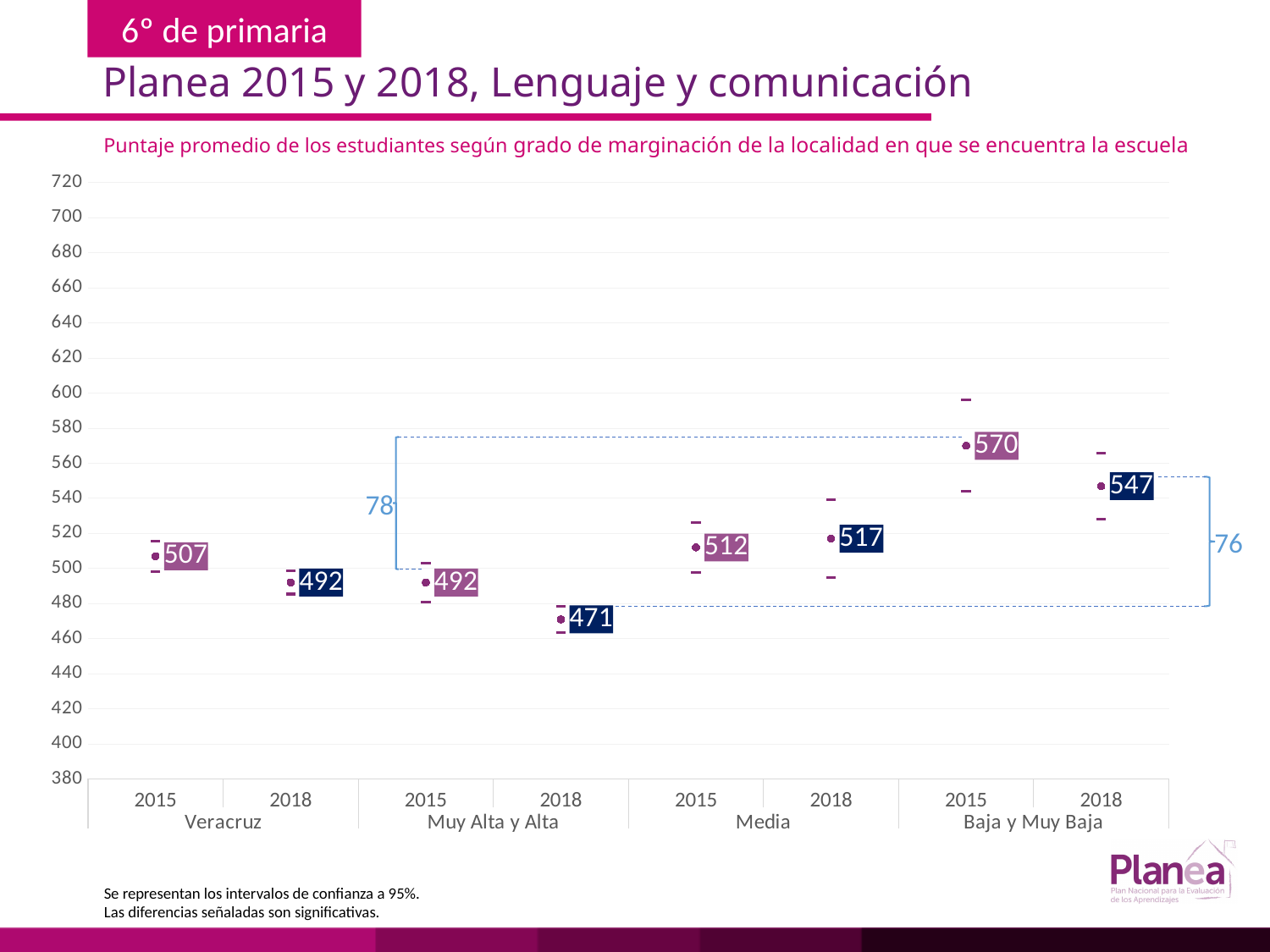
What is the average score for the Media marginación group in 2018? 517 What is the difference between the 2015 and 2018 scores for Veracruz? 15 What is the average score for the Muy Alta y Alta marginación group in 2018? 471 What is the difference between the 2015 and 2018 scores for Baja y Muy Baja? 23 Which group and year has the highest average score? Baja y Muy Baja, 2015 What is the average score for Veracruz in 2015? 507 How many data points are plotted on the chart? 8 Which is larger, the 2015 score for Media or the 2018 score for Media? 2018 (517) Did the average score for Muy Alta y Alta rise or fall from 2015 to 2018? fall What is the average score for the Baja y Muy Baja marginación group in 2015? 570 Which group and year has the lowest average score? Muy Alta y Alta, 2018 What difference is annotated between the 2018 scores of Baja y Muy Baja and Muy Alta y Alta? 76